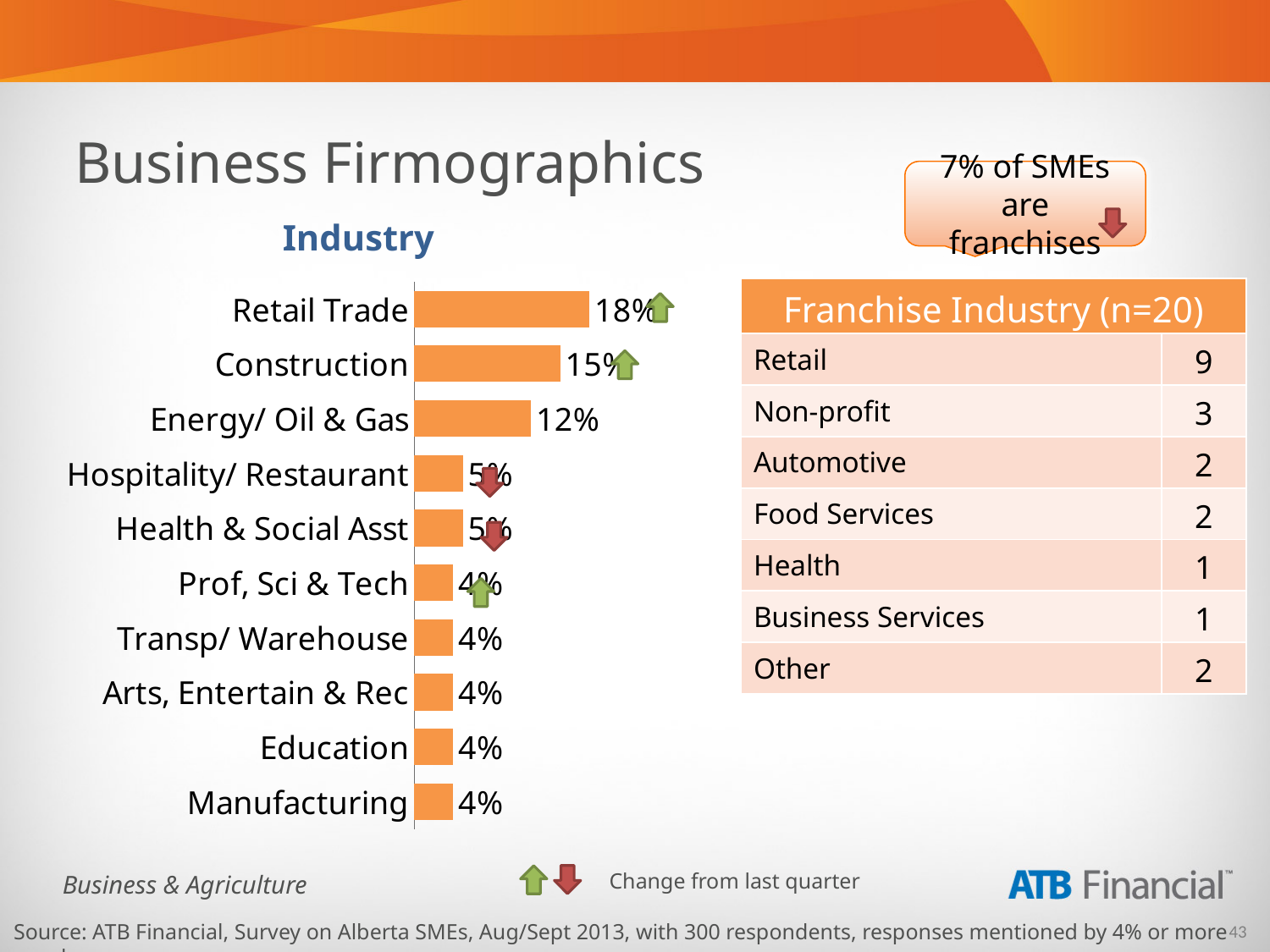
What kind of chart is the Industry chart? Bar chart What is the value for Retail Trade in the Industry chart? 18% What is the title of the bar chart on the slide? Industry What is the value for Hospitality/ Restaurant in the Industry chart? 5% What is the difference between the values for Retail Trade and Construction in the Industry chart? 3% What is the value for Energy/ Oil & Gas in the Industry chart? 12% What is the value for Construction in the Industry chart? 15% How many industry categories are shown in the Industry chart? 10 What is the value for Manufacturing in the Industry chart? 4% Which is larger in the Industry chart, the value for Energy/ Oil & Gas or the value for Hospitality/ Restaurant? Energy/ Oil & Gas What is the difference between the values for Construction and Energy/ Oil & Gas in the Industry chart? 3% Which industry has the highest value in the Industry chart? Retail Trade